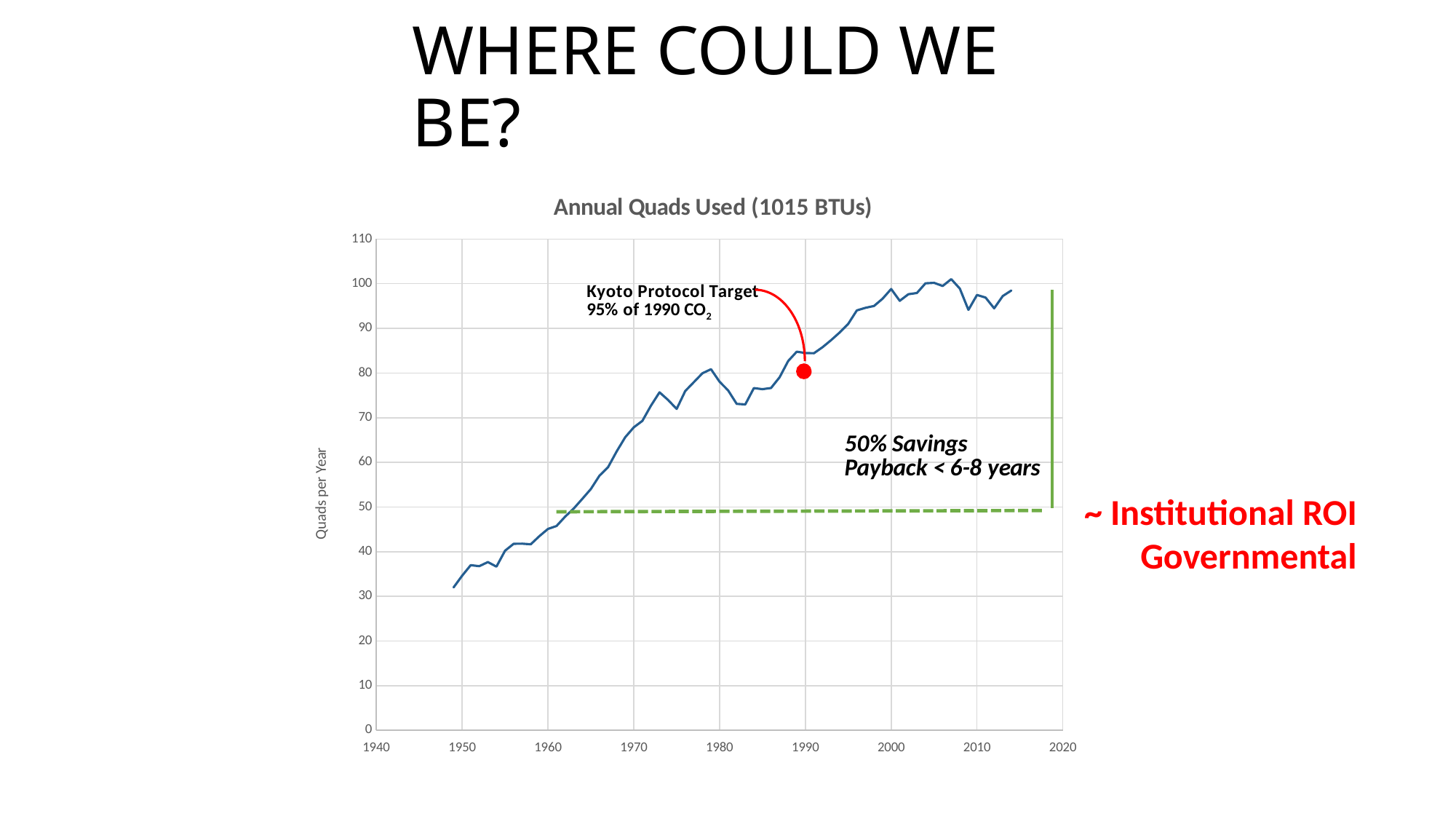
Is the value for 2010 greater or less than 90? greater Which is larger, the value for 1980 or the value for 1960? 1980 Overall, do the plotted values rise or fall from 1950 to 2010? rise What is the title of the chart? Annual Quads Used (1015 BTUs) Is the value for 1950 greater or less than 40? less Is the value for 1960 greater or less than 50? less What kind of chart is shown on the slide? line chart What is the highest tick value shown on the vertical axis? 110 What is the label on the vertical axis of the chart? Quads per Year